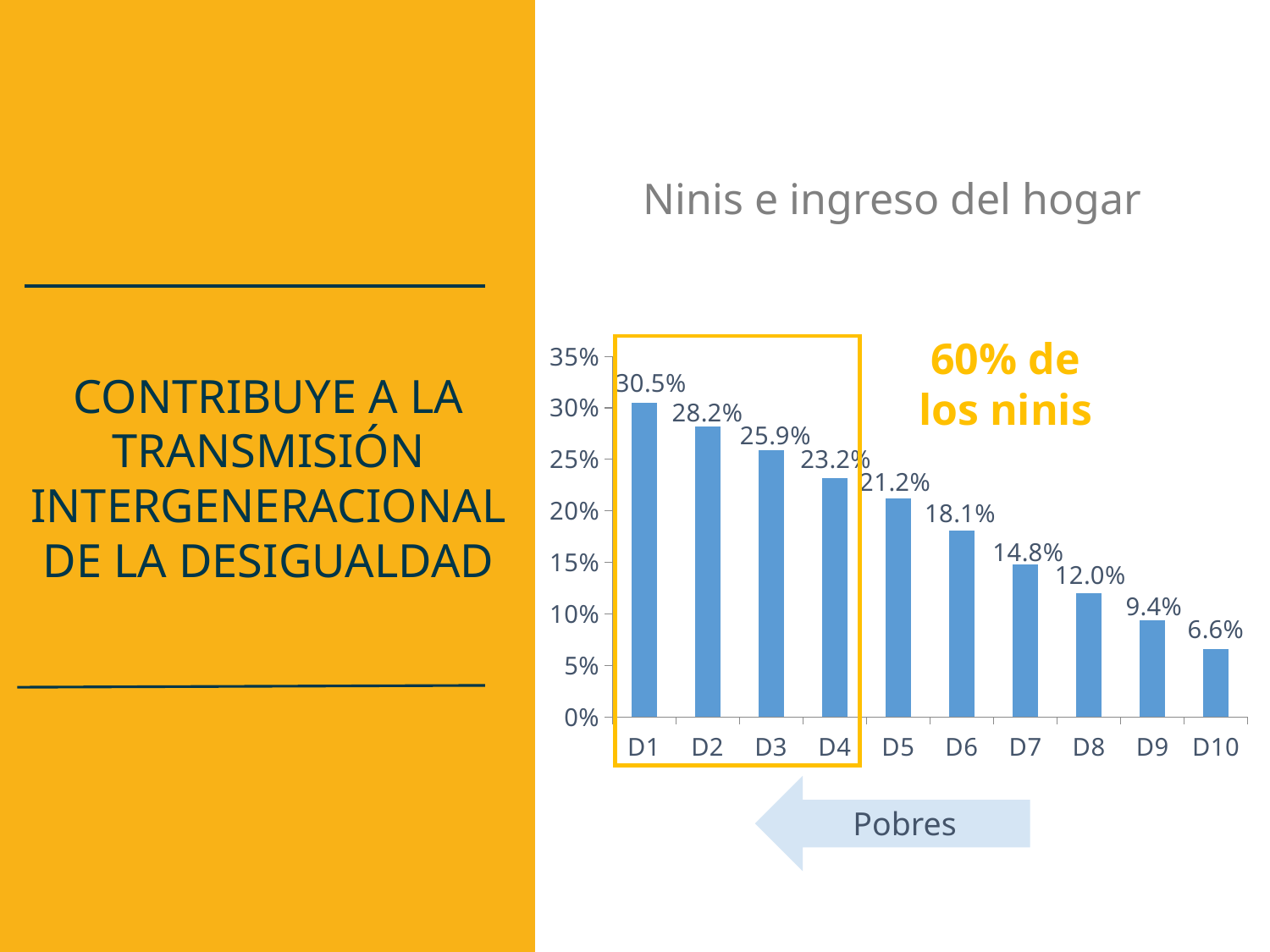
Which category has the highest value? D1 What is the value for D10? 6.6% What is the title of the chart? Ninis e ingreso del hogar Which category has the lowest value? D10 What is the value for D6? 18.1% How many categories are shown on the x axis? 10 What is the difference between the values for D1 and D10? 23.9% What is the value for D1? 30.5% What is the difference between the values for D4 and D5? 2.0% Do the values rise or fall from D1 to D10? Fall What kind of chart is this? Bar chart Which is larger, the value for D3 or the value for D7? D3